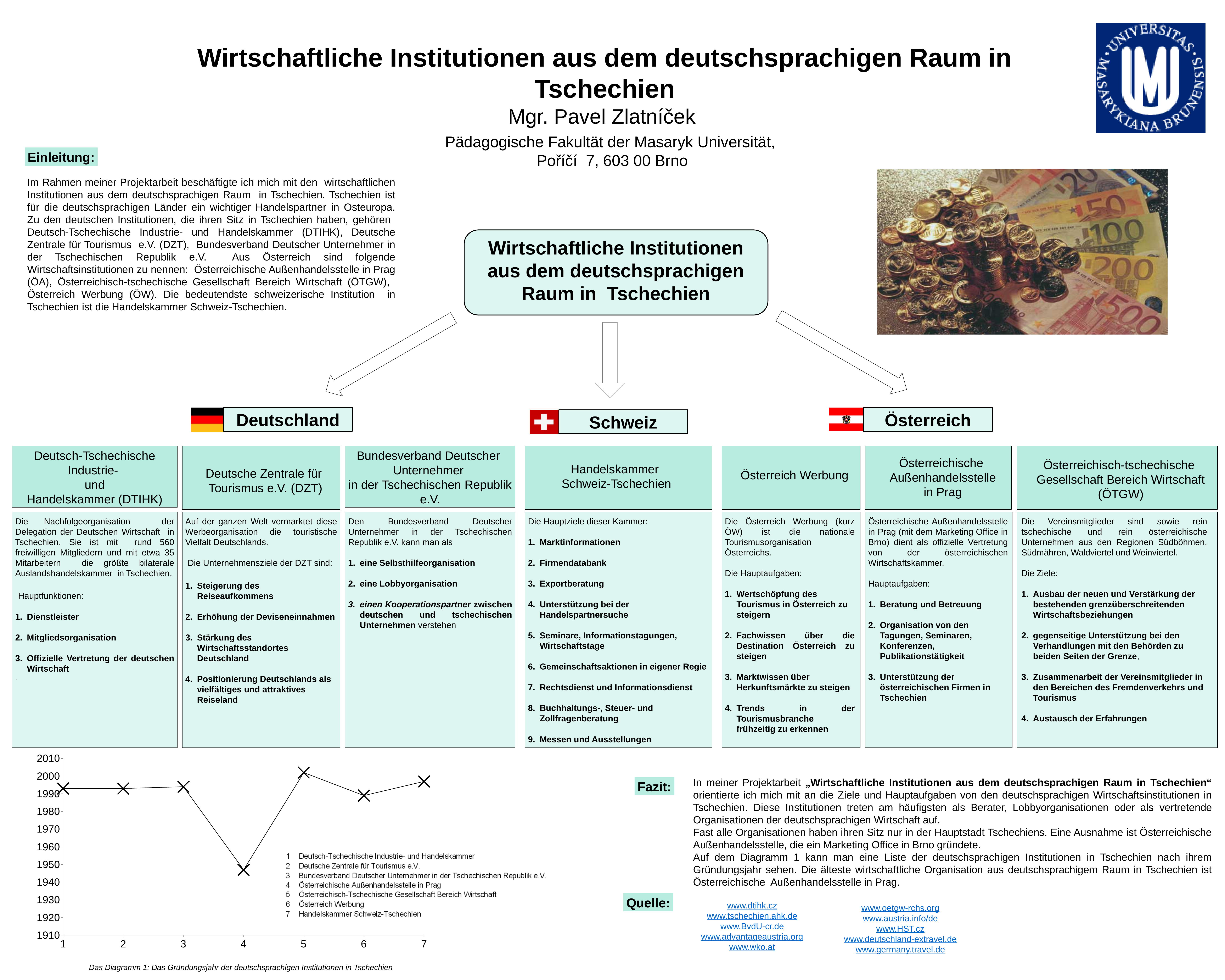
In Diagramm 1, which institution (by its number) has the lowest founding year? 4 (Österreichische Außenhandelsstelle in Prag) In Diagramm 1, which has the larger value: institution 4 or institution 5? institution 5 What is the caption of the chart at the bottom left of the slide? Das Diagramm 1: Das Gründungsjahr der deutschsprachigen Institutionen in Tschechien In Diagramm 1, is the value for institution 5 greater or less than 1990? greater What kind of chart is Diagramm 1 at the bottom left of the slide? line chart How many data points are plotted in Diagramm 1? 7 In Diagramm 1, is the value for institution 6 greater or less than 1970? greater In Diagramm 1, is the value for institution 1 greater or less than 1980? greater In Diagramm 1, which institution is listed as number 7 in the key? Handelskammer Schweiz-Tschechien In Diagramm 1, which institution (by its number) has the highest founding year? 5 (Österreichisch-Tschechische Gesellschaft Bereich Wirtschaft) In Diagramm 1, which has the larger value: institution 6 or institution 7? institution 7